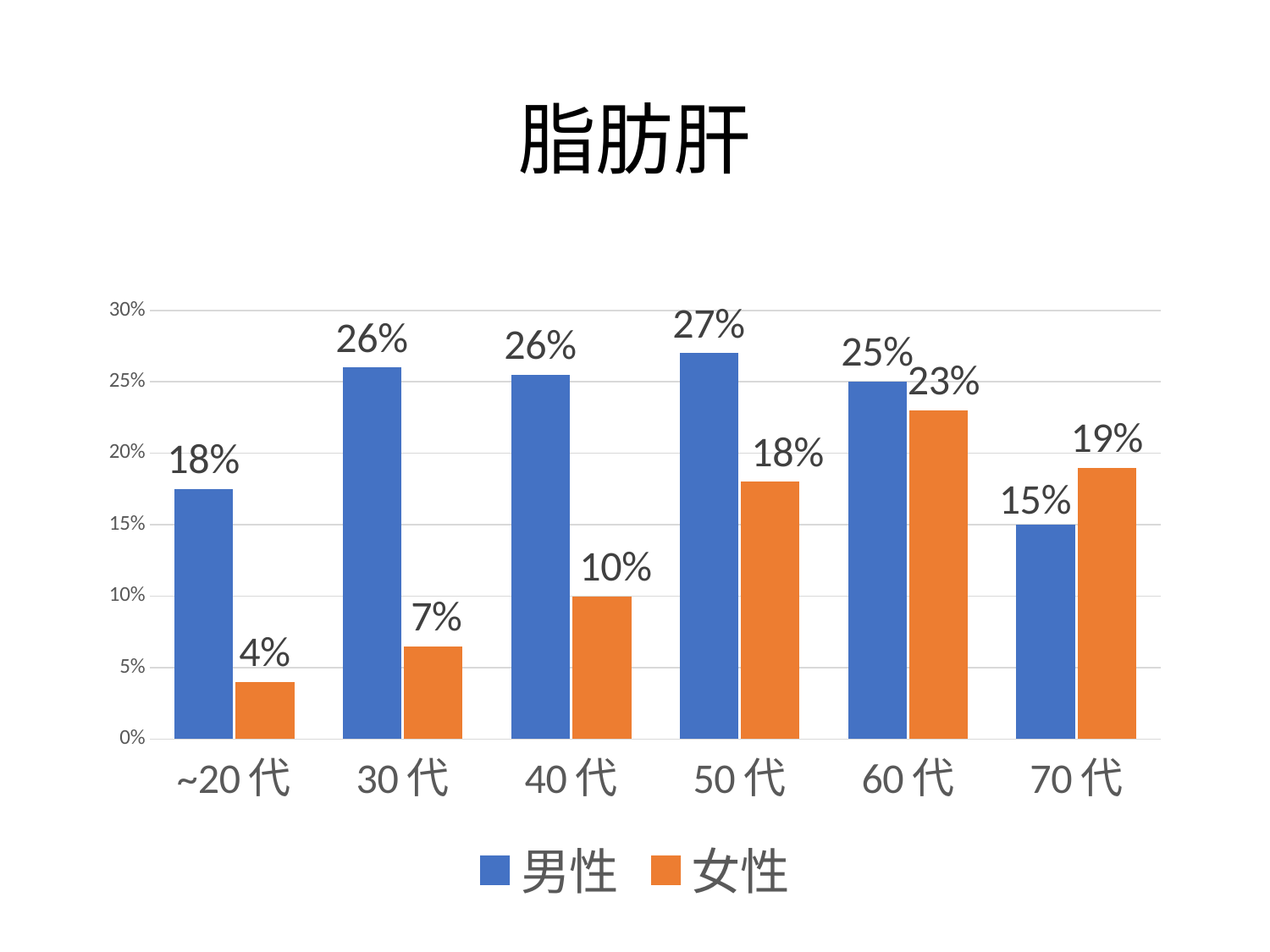
What is the title of the chart? 脂肪肝 How many age categories are shown on the x axis? 6 How many series does the legend list? 2 What is the difference between the 男性 and 女性 values in the 30代 category? 19% What is the value for 女性 in the 60代 category? 23% Is the value for 女性 in the 40代 category greater or less than 15%? less What is the value for 男性 in the 50代 category? 27% Which age category has the lowest value for 女性? ~20代 What is the value for 女性 in the ~20代 category? 4% In the 70代 category, which is larger, the 男性 value or the 女性 value? 女性 What kind of chart is shown on the slide? bar chart Which age category has the highest value for 男性? 50代